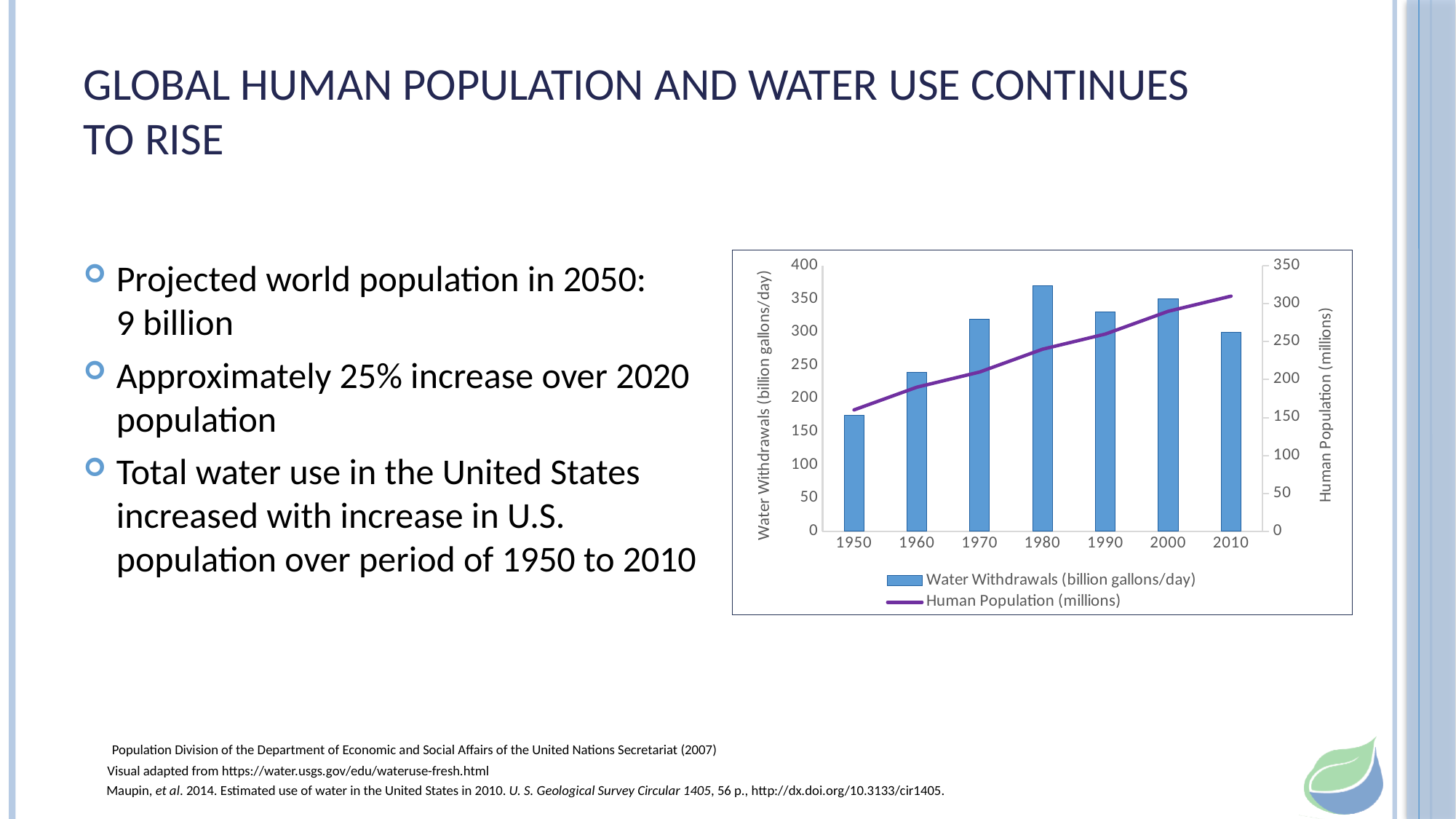
Is the Water Withdrawals value for 2010 greater or less than 250? greater Does the Human Population line rise or fall from 1950 to 2010? rise How many series does the chart legend list? 2 Is the Human Population value for 1950 greater or less than 200 million? less Is the Water Withdrawals value for 1950 greater or less than 200? less How many years are shown on the x axis of the chart? 7 Which year has the larger Water Withdrawals bar, 1960 or 1990? 1990 Which year has the lowest Water Withdrawals bar? 1950 Which year has the highest Water Withdrawals bar? 1980 What is the label of the left vertical axis of the chart? Water Withdrawals (billion gallons/day)